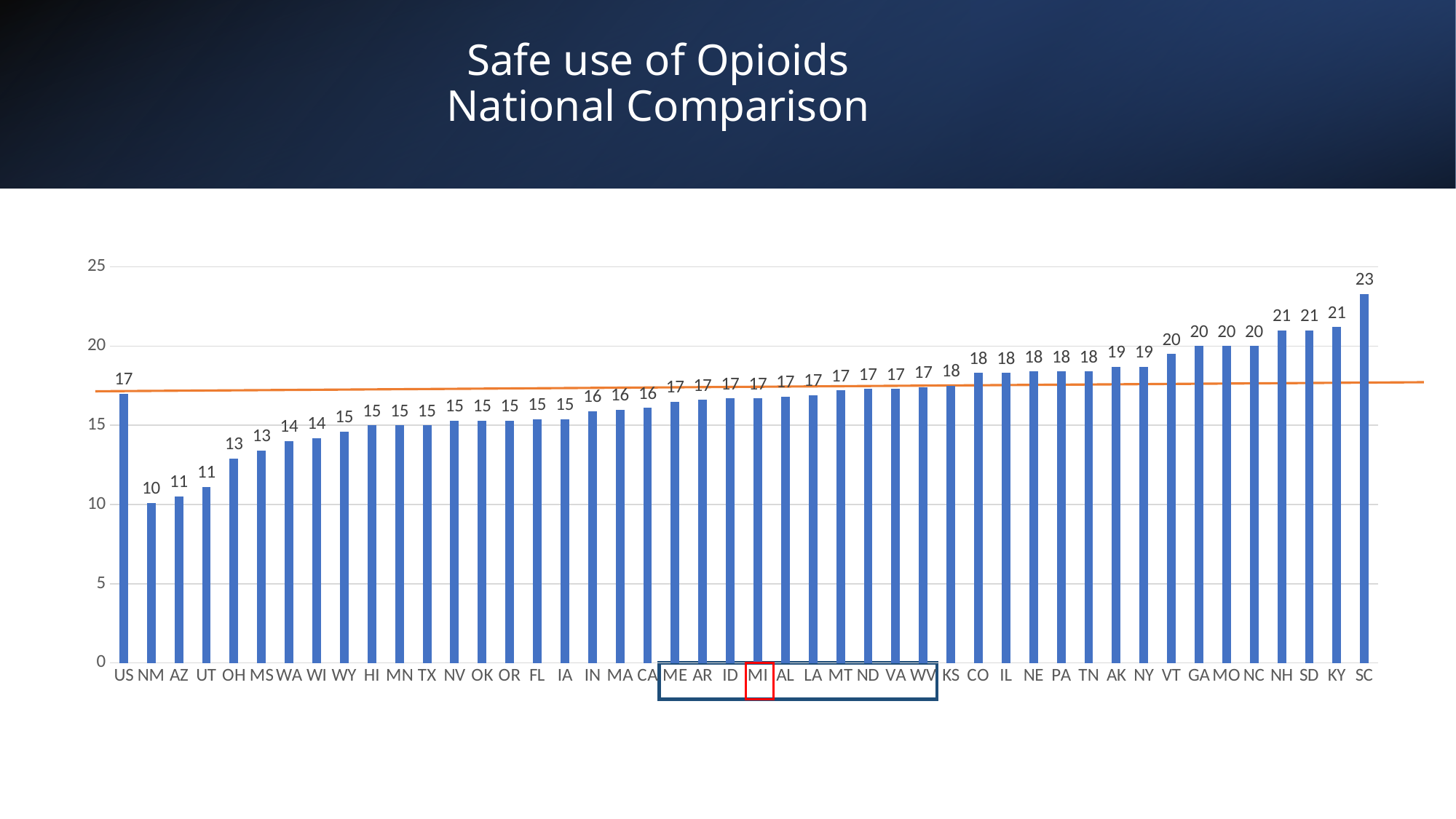
What is the value for MI? 17 What is the value for NM? 10 What is the difference between the values for SC and US? 6 What kind of chart is shown on the slide? bar chart Which category has the lowest value? NM Do the bar values generally rise or fall from left to right along the x axis? rise Is the value for SC greater or less than 20? greater Which is larger, the value for OH or the value for VT? VT What is the value for US? 17 Which category has the highest value? SC What is the difference between the values for SC and NM? 13 What is the value for SC? 23